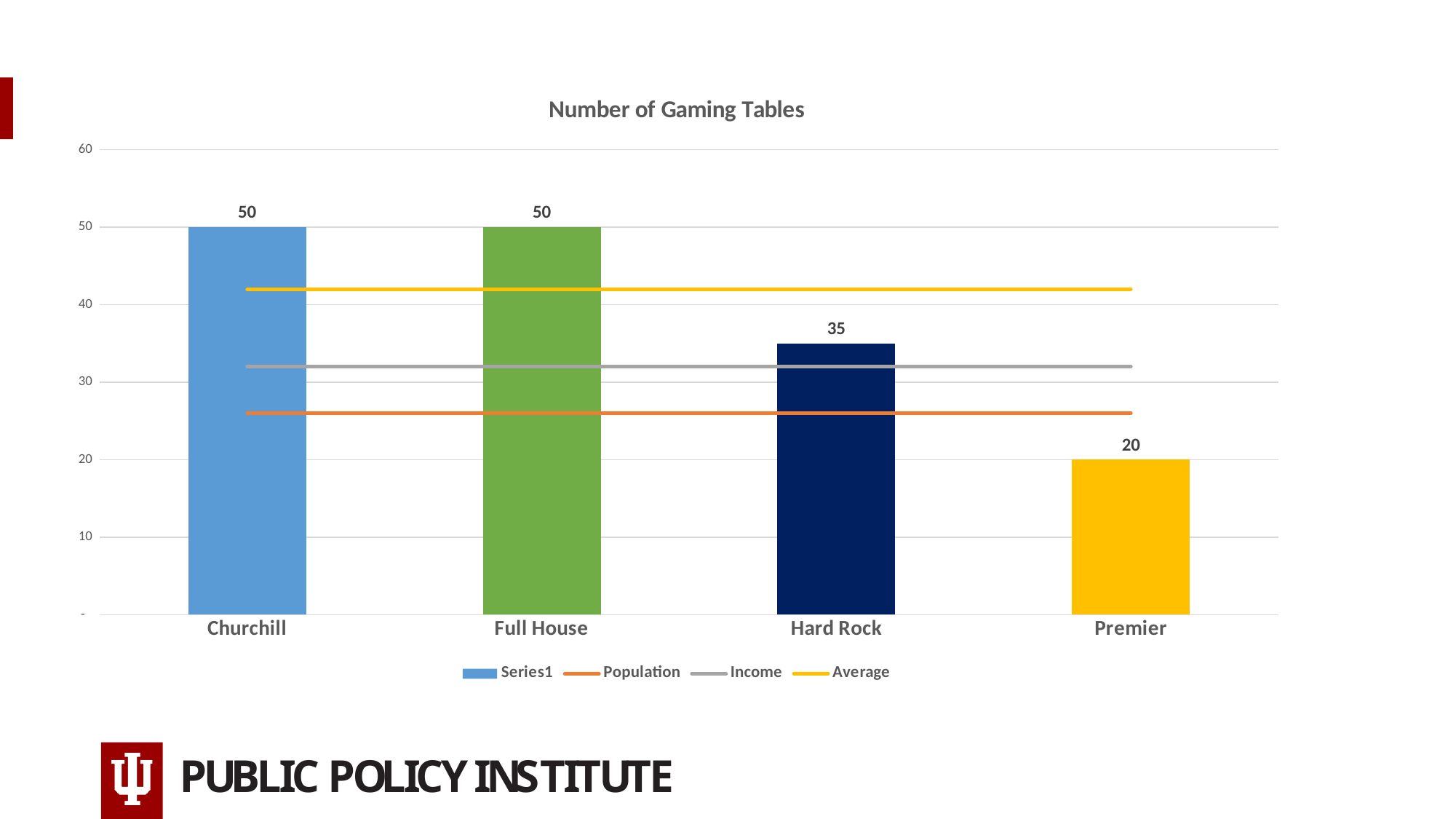
Is the Average line greater or less than 40? greater What is the number of gaming tables for Premier? 20 How many series does the legend list? 4 What is the title of the chart? Number of Gaming Tables What is the number of gaming tables for Churchill? 50 Is the Population line greater or less than 30? less How many casinos are shown on the x axis? 4 What is the difference in gaming tables between Churchill and Premier? 30 Which casino has the lowest number of gaming tables? Premier Which has more gaming tables, Hard Rock or Premier? Hard Rock What is the number of gaming tables for Hard Rock? 35 What is the difference in gaming tables between Full House and Hard Rock? 15